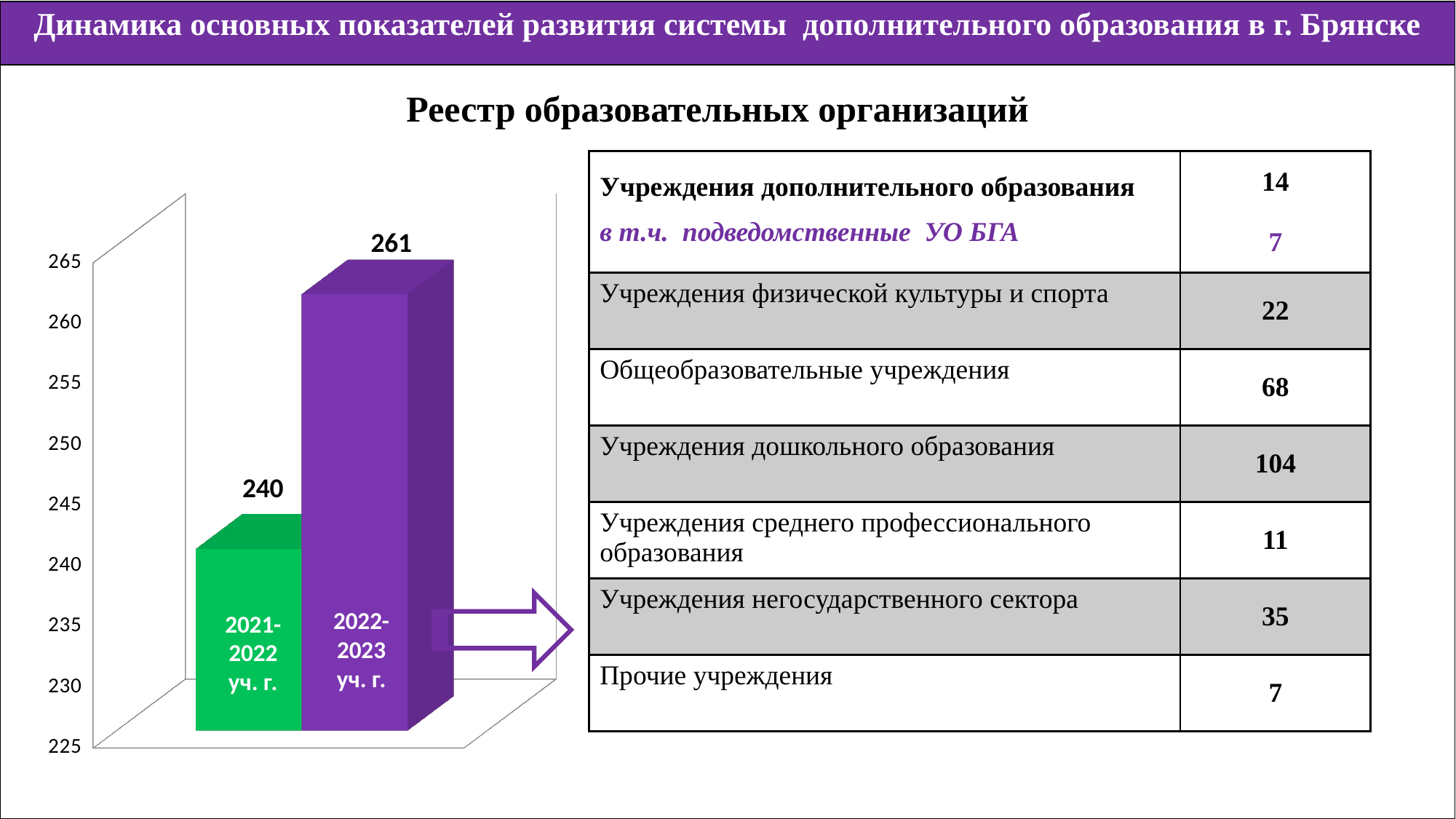
Is the value for 2021-2022 уч. г. greater or less than 245? less How many bars are shown in the chart? 2 What is the value for 2022-2023 уч. г. in the bar chart? 261 What kind of chart is shown on the slide? bar chart Do the values rise or fall from 2021-2022 уч. г. to 2022-2023 уч. г.? rise Is the value for 2022-2023 уч. г. greater or less than 255? greater By how much does the value for 2022-2023 уч. г. exceed the value for 2021-2022 уч. г.? 21 Which academic year has the higher value in the bar chart? 2022-2023 уч. г. Is the value for 2021-2022 уч. г. larger or smaller than the value for 2022-2023 уч. г.? smaller What is the value for 2021-2022 уч. г. in the bar chart? 240 Which academic year has the lower value in the bar chart? 2021-2022 уч. г. What colour is the bar for 2022-2023 уч. г.? purple